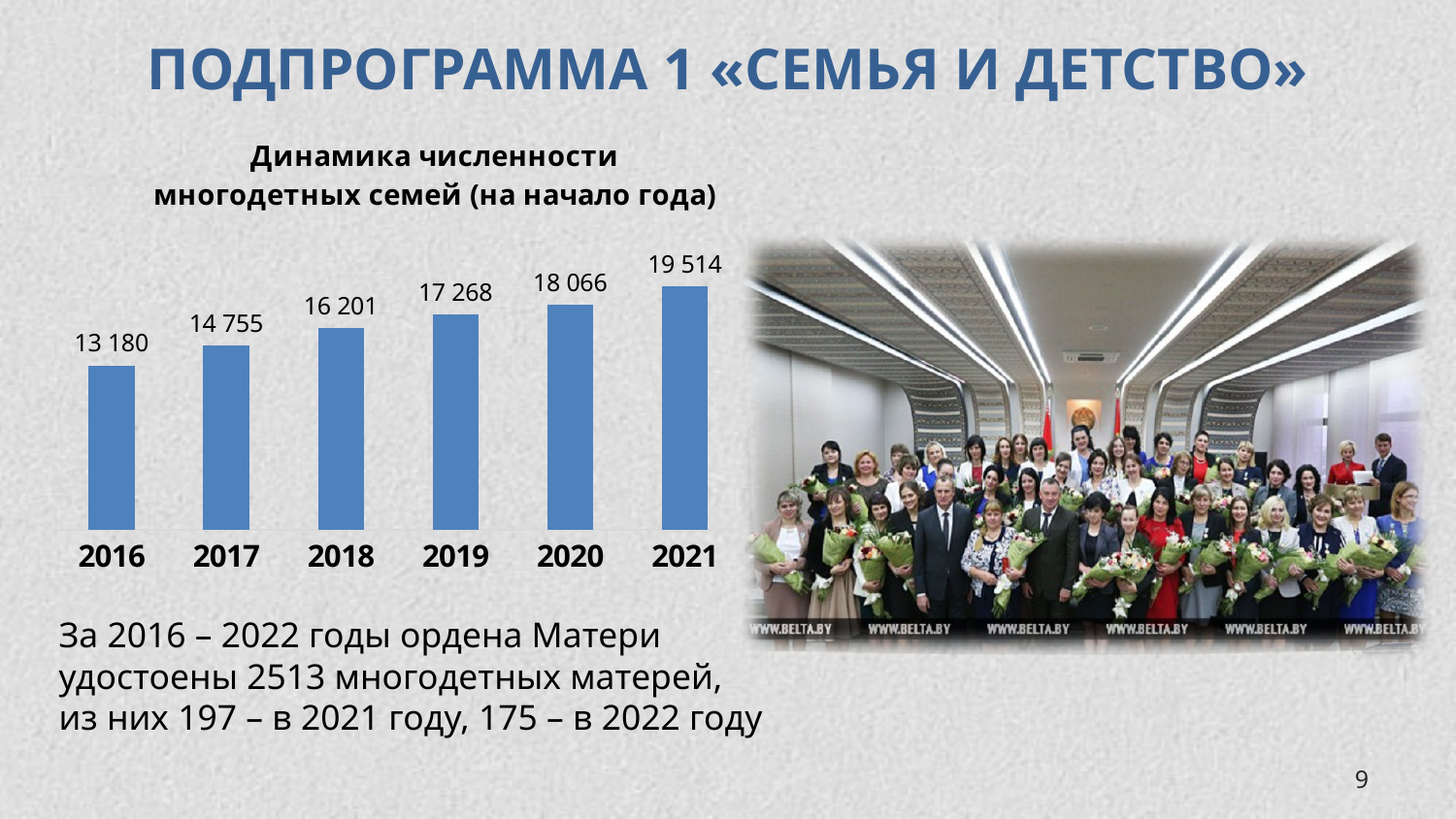
Which year has the highest value in the chart? 2021 What kind of chart is shown on the slide? bar chart What is the value for 2021 in the chart? 19 514 Do the values rise or fall from 2016 to 2021? rise What is the difference between the values for 2018 and 2017? 1 446 What is the title of the chart? Динамика численности многодетных семей (на начало года) What is the value for 2016 in the chart? 13 180 What is the value for 2019 in the chart? 17 268 Which is larger, the value for 2020 or the value for 2018? 2020 How many years are shown in the chart? 6 Which year has the lowest value in the chart? 2016 What is the difference between the values for 2021 and 2016? 6 334